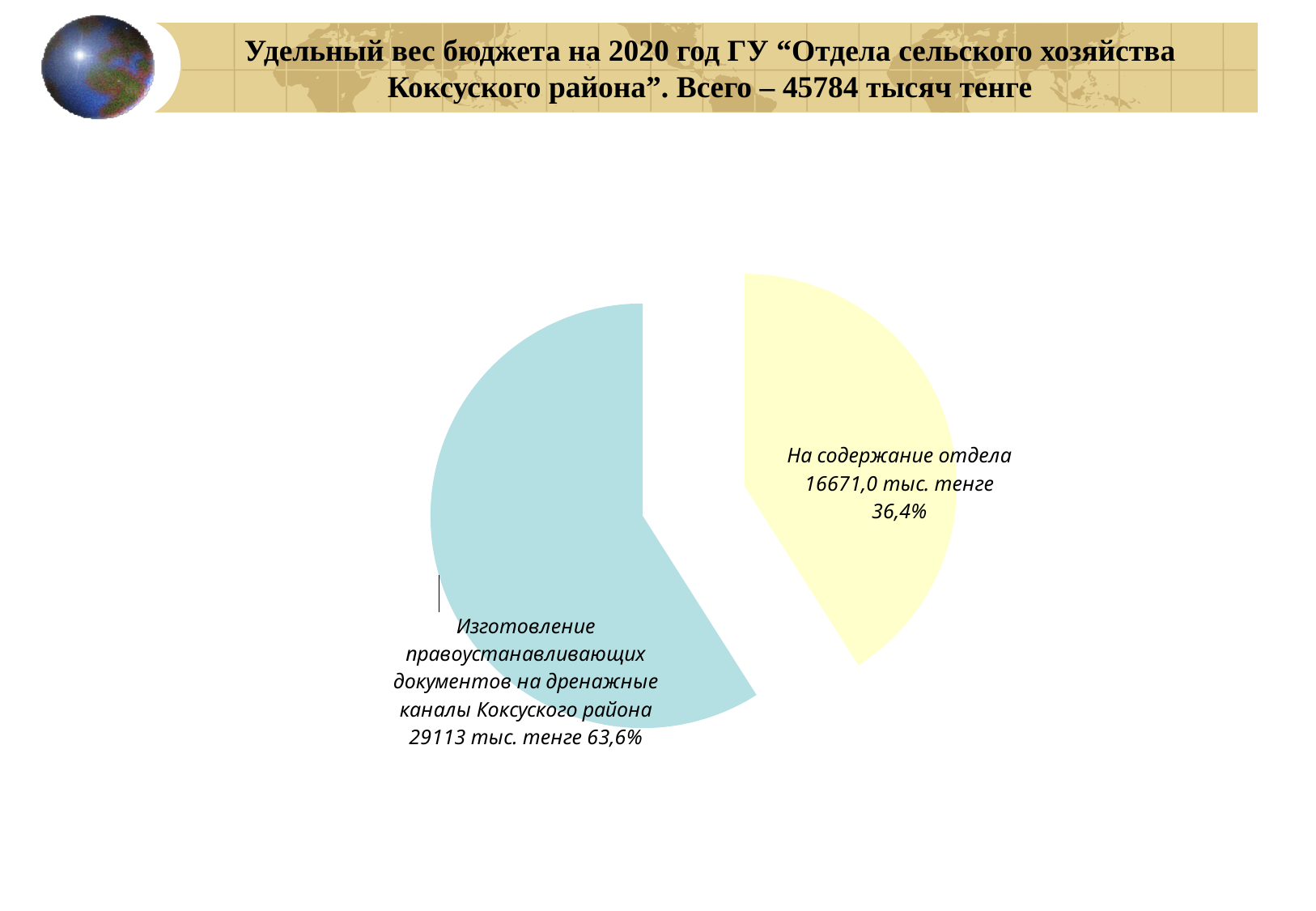
What kind of chart is shown on the slide? pie chart What total budget is stated in the slide title? 45784 тысяч тенге What share of the pie does "Изготовление правоустанавливающих документов на дренажные каналы Коксуского района" represent? 63,6% What is the value for "На содержание отдела"? 16671,0 тыс. тенге What is the difference in percentage points between the two slices? 27,2 Which is larger: "На содержание отдела" or "Изготовление правоустанавливающих документов на дренажные каналы Коксуского района"? Изготовление правоустанавливающих документов на дренажные каналы Коксуского района Which slice is the largest? Изготовление правоустанавливающих документов на дренажные каналы Коксуского района How many slices does the pie chart have? 2 Which slice is the smallest? На содержание отдела What is the value for "Изготовление правоустанавливающих документов на дренажные каналы Коксуского района"? 29113 тыс. тенге What share of the pie does "На содержание отдела" represent? 36,4% What colour is the slice for "На содержание отдела"? yellow